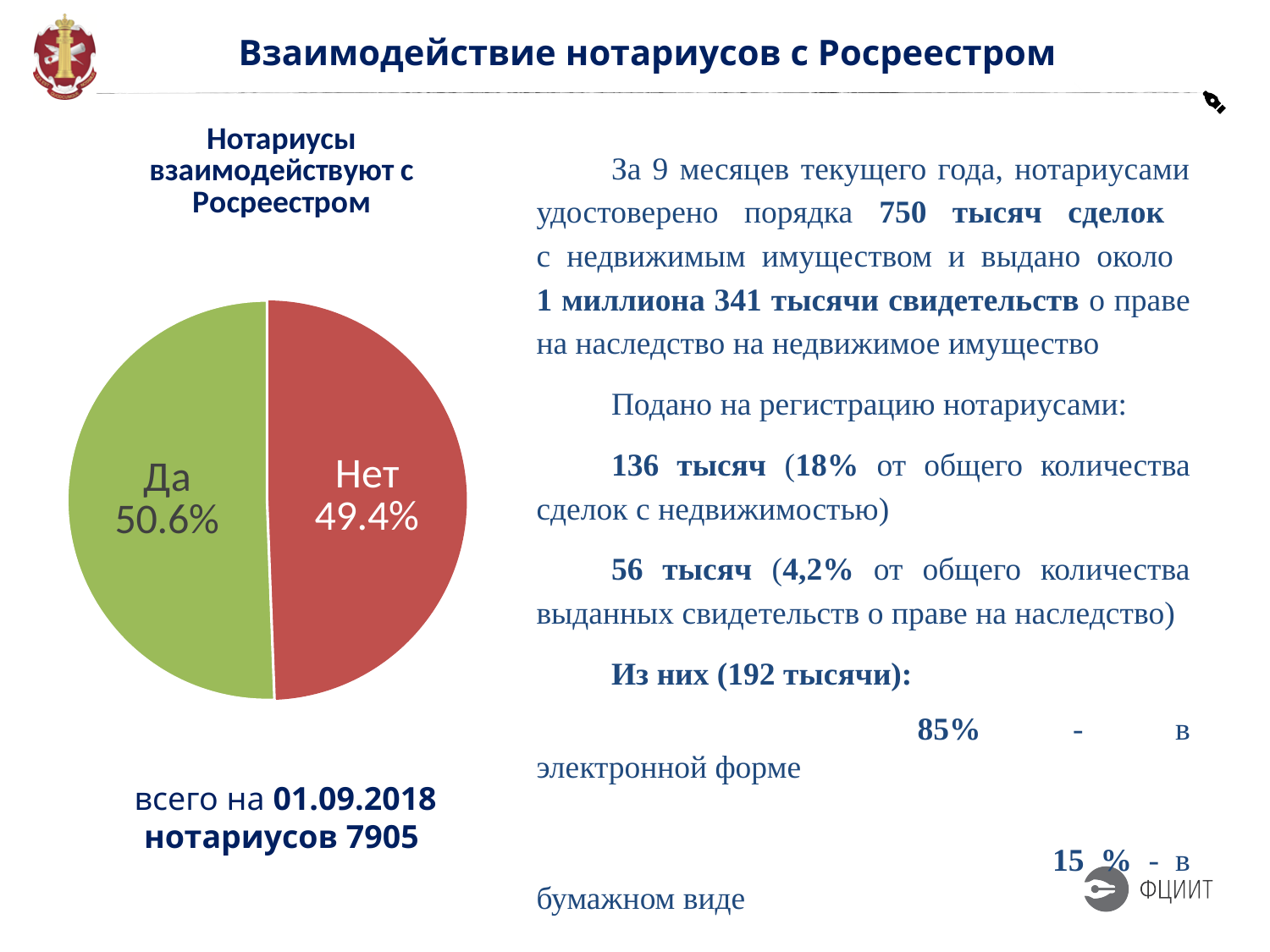
What share of the pie chart is labelled "Да"? 50.6% Which slice of the pie chart is the smallest? Нет Is the share for "Нет" greater or less than 50%? less What share of the pie chart is labelled "Нет"? 49.4% How many slices does the pie chart have? 2 Which slice of the pie chart is larger, "Да" or "Нет"? Да Is the share for "Да" greater or less than 50%? greater What colour is the "Да" slice of the pie chart? green What kind of chart is shown on the slide? pie chart What is the difference in percentage points between the "Да" and "Нет" slices? 1.2 What is the title of the pie chart? Нотариусы взаимодействуют с Росреестром